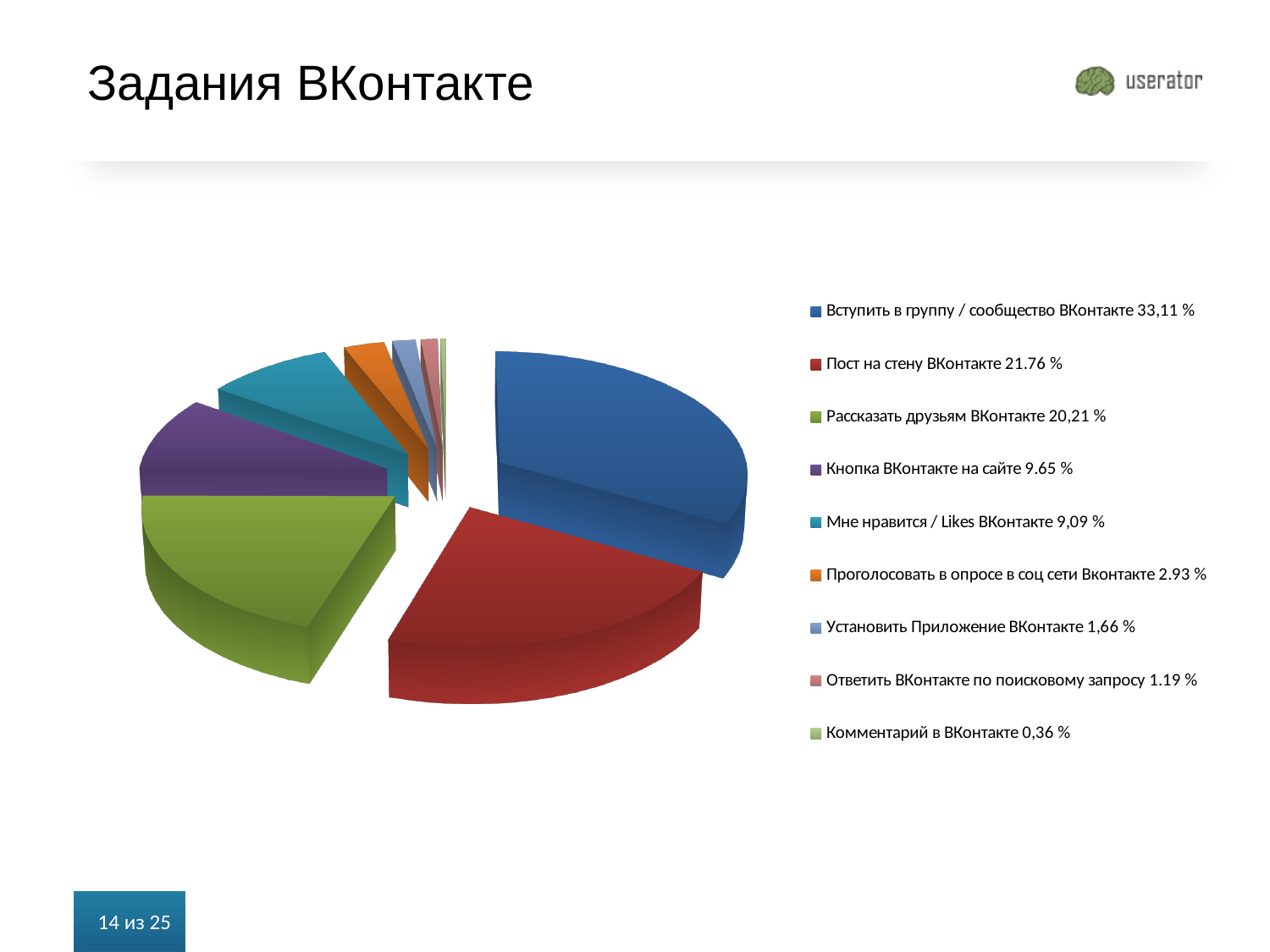
What share does "Комментарий в ВКонтакте" have according to the legend? 0,36 % What kind of chart is shown on the slide? pie chart What is the title of the slide with the pie chart? Задания ВКонтакте Which category has the smallest slice of the pie? Комментарий в ВКонтакте What colour is the slice for "Пост на стену ВКонтакте"? red What share does "Вступить в группу / сообщество ВКонтакте" have according to the legend? 33,11 % What is the difference in percentage points between "Вступить в группу / сообщество ВКонтакте" and "Пост на стену ВКонтакте"? 11.35 What share does "Пост на стену ВКонтакте" have according to the legend? 21.76 % How many slices does the pie chart have? 9 Which category has the largest slice of the pie? Вступить в группу / сообщество ВКонтакте What share does "Кнопка ВКонтакте на сайте" have according to the legend? 9.65 % Which is larger: the share for "Рассказать друзьям ВКонтакте" or for "Мне нравится / Likes ВКонтакте"? Рассказать друзьям ВКонтакте